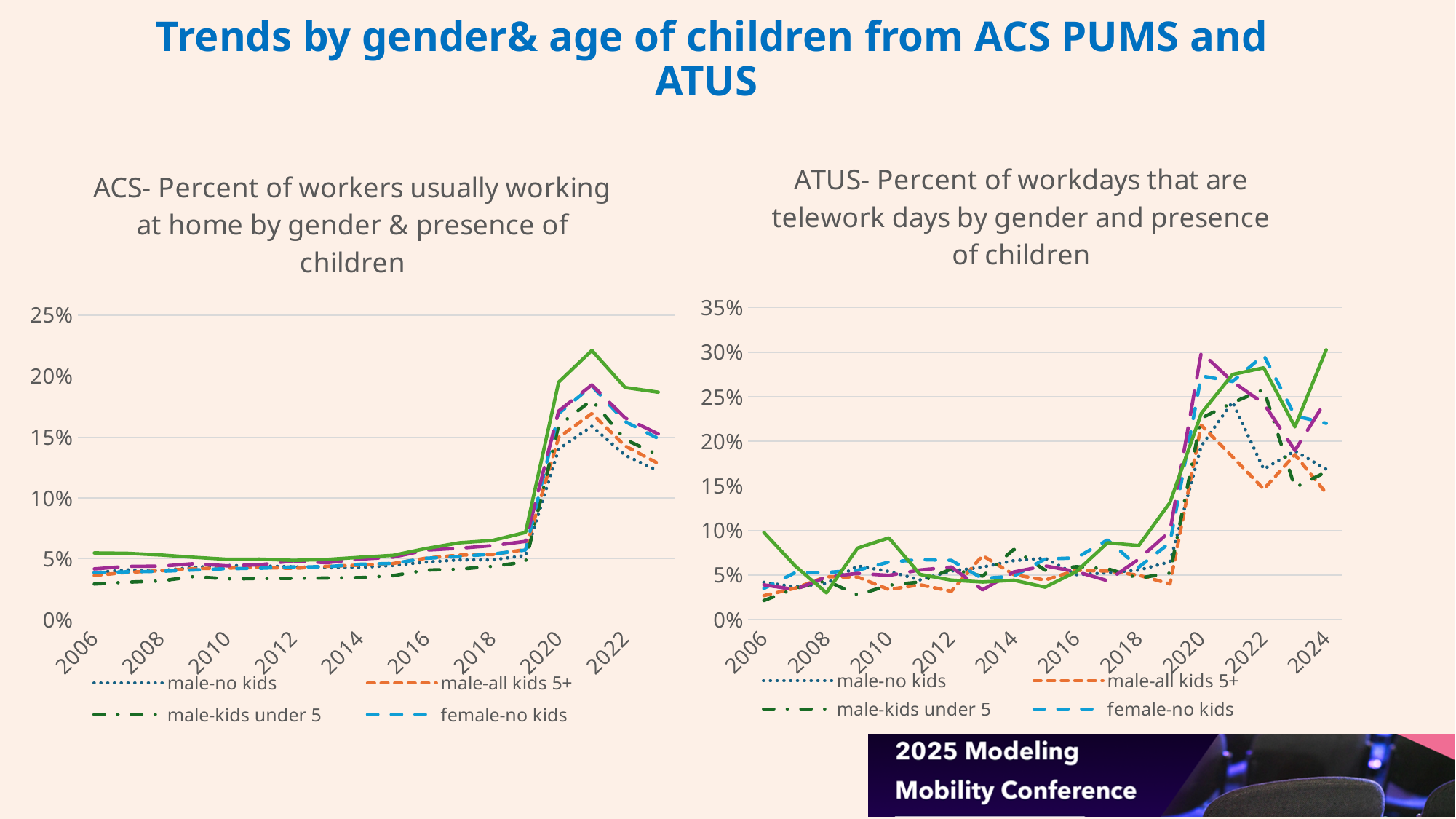
In the ACS chart on the left, how many series does the legend list? 4 In the ACS chart on the left, does the male-no kids series rise or fall overall from 2006 to 2020? rise In the ACS chart on the left, is the value for male-no kids in 2020 greater or less than 10%? greater In the ATUS chart on the right, how many year labels are shown on the x axis? 10 In the ATUS chart on the right, is the value for female-no kids in 2022 greater or less than 25%? greater In the ATUS chart on the right, is the value for male-kids under 5 in 2006 greater or less than 5%? less In the ACS chart on the left, how many year labels are shown on the x axis? 9 In the ACS chart on the left, which is higher in 2020: female-no kids or male-no kids? female-no kids In the ATUS chart on the right, which is higher in 2024: female-no kids or male-all kids 5+? female-no kids What kind of chart is the ACS chart on the left? line chart What kind of chart is the ATUS chart on the right? line chart